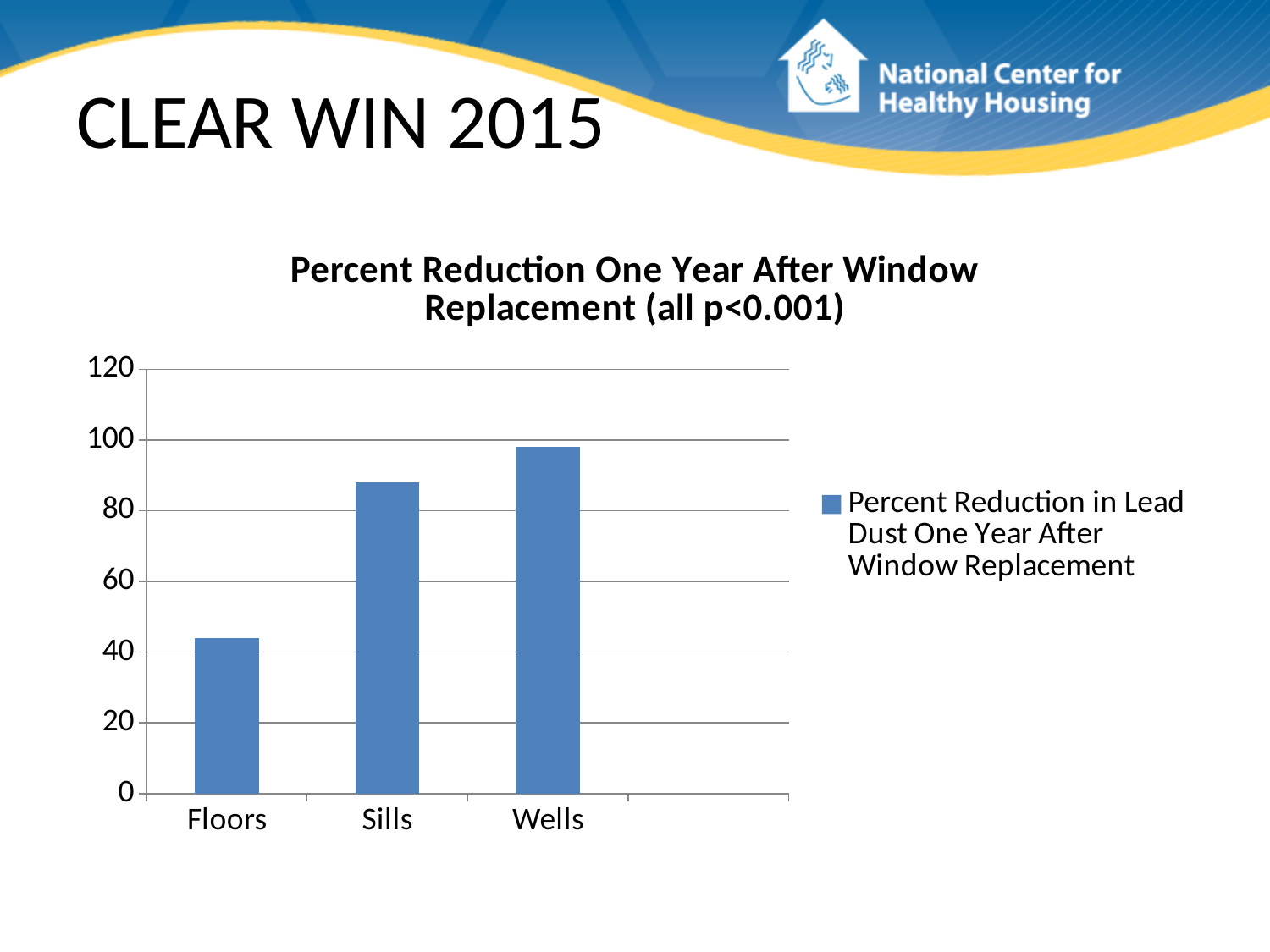
How many series does the chart's legend list? 1 Which has a larger percent reduction, Floors or Sills? Sills Which category has the highest percent reduction? Wells Do the values rise or fall moving from Floors to Wells along the x axis? rise Which category has the lowest percent reduction? Floors Is the value for Wells greater or less than 80? greater How many categories are shown on the x axis of the chart? 3 What is the title of the chart? Percent Reduction One Year After Window Replacement (all p<0.001) Which has a larger percent reduction, Sills or Wells? Wells Is the value for Sills greater or less than 80? greater What kind of chart is shown on the slide? bar chart Is the value for Floors greater or less than 60? less